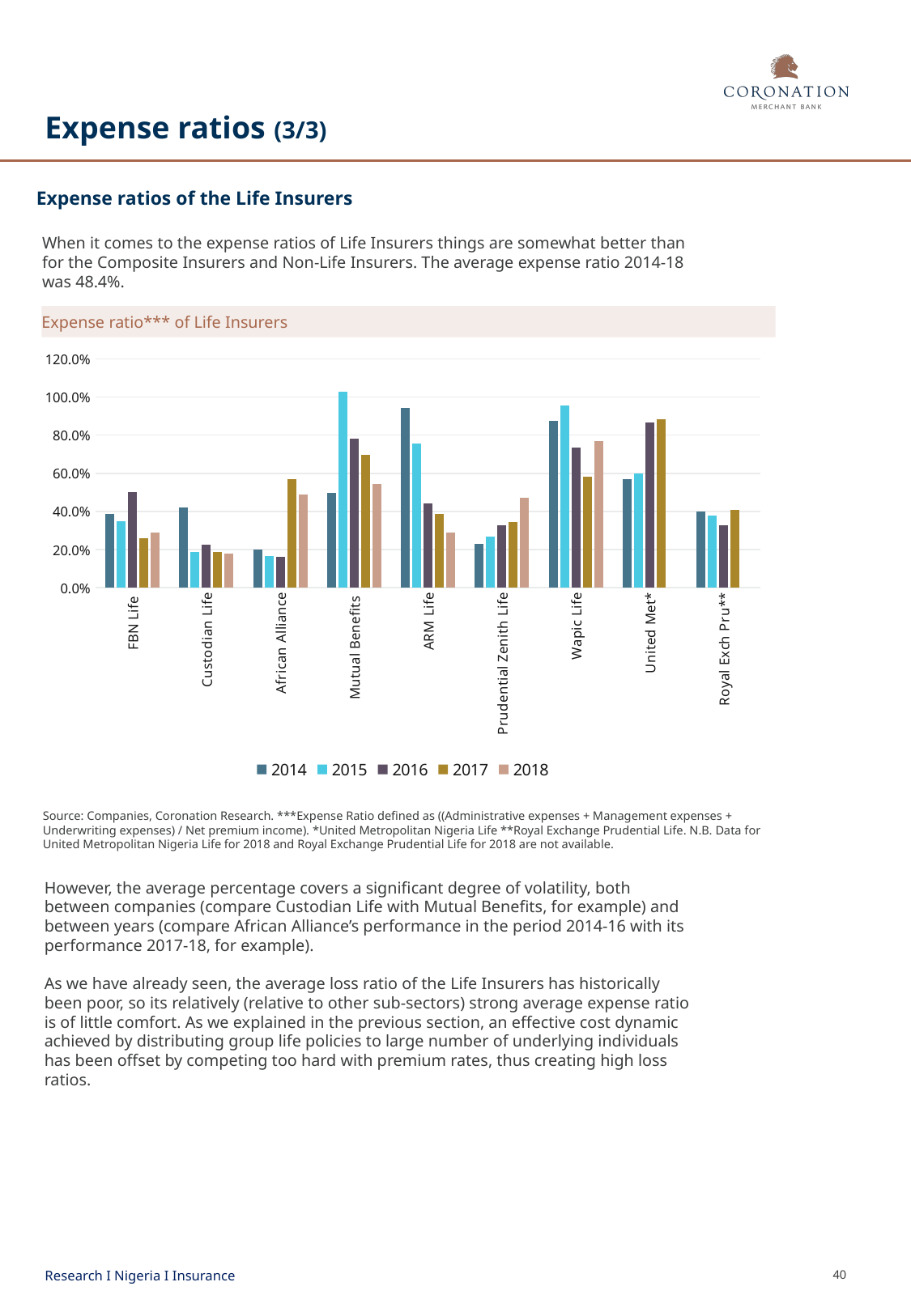
What is the title of the chart? Expense ratio*** of Life Insurers Which is larger, the 2015 value for Mutual Benefits or the 2015 value for Custodian Life? Mutual Benefits Is the 2017 value for United Met* greater or less than 80.0%? greater Is the 2014 value for ARM Life greater or less than 80.0%? greater For African Alliance, which is larger, the 2014 value or the 2017 value? 2017 How many series does the chart's legend list? 5 Is the 2015 value for Custodian Life greater or less than 40.0%? less What kind of chart is shown on the slide? bar chart How many insurers (categories) are shown on the x axis of the chart? 9 Which insurer has the highest 2015 expense ratio in the chart? Mutual Benefits Do the values for Mutual Benefits rise or fall from 2015 to 2018? fall